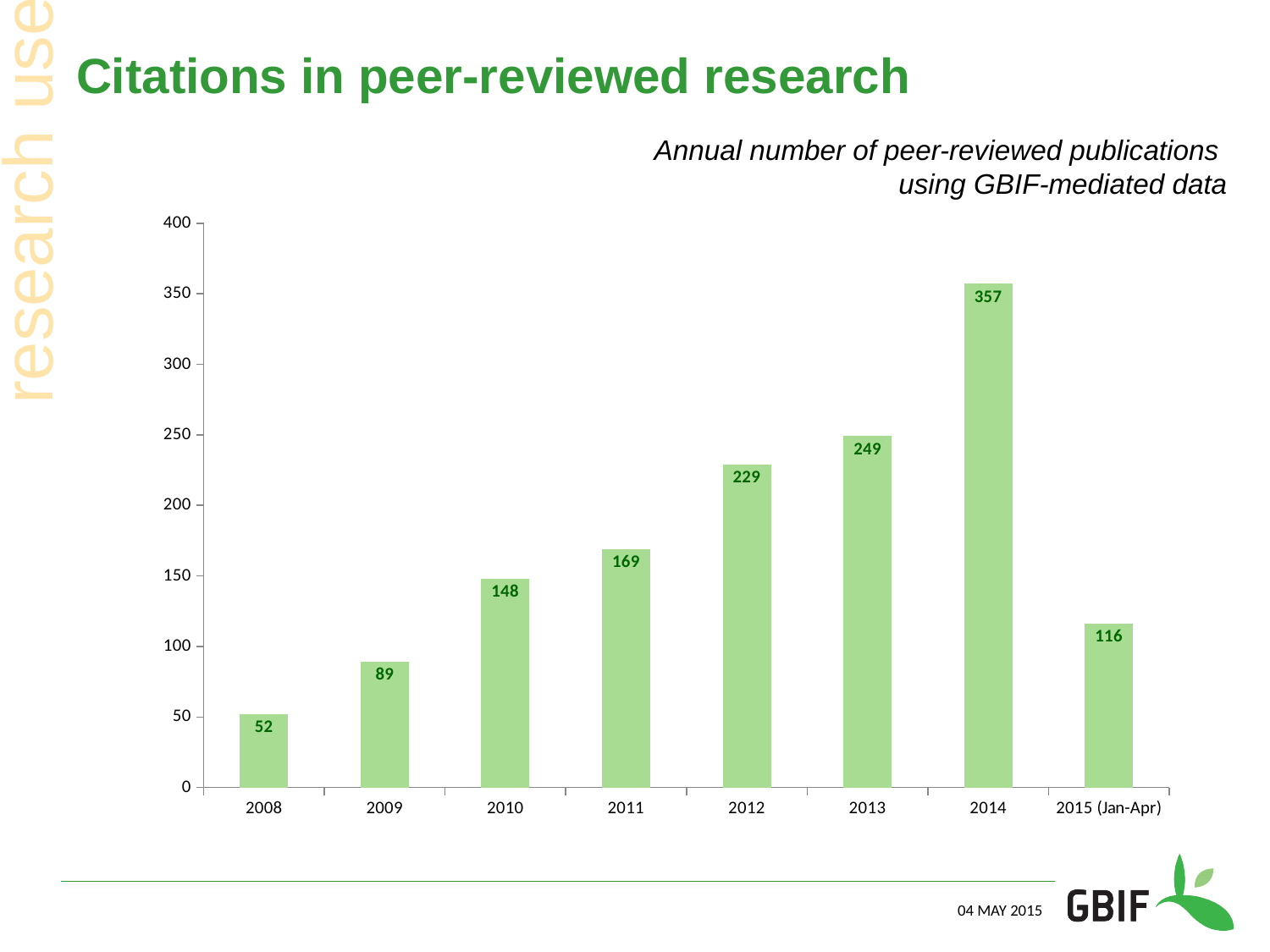
What kind of chart is shown on the slide? Bar chart What is the value shown for 2015 (Jan-Apr)? 116 Which category has the lowest number of publications? 2008 What is the subtitle of the chart? Annual number of peer-reviewed publications using GBIF-mediated data What is the number of peer-reviewed publications for 2008? 52 How many categories are shown on the x axis? 8 Is the value for 2010 greater or less than 100? greater Which is larger, the value for 2011 or the value for 2012? 2012 What is the difference between the values for 2014 and 2013? 108 What is the number of peer-reviewed publications for 2014? 357 Do the values rise or fall from 2008 to 2014? Rise Which year has the highest number of publications? 2014